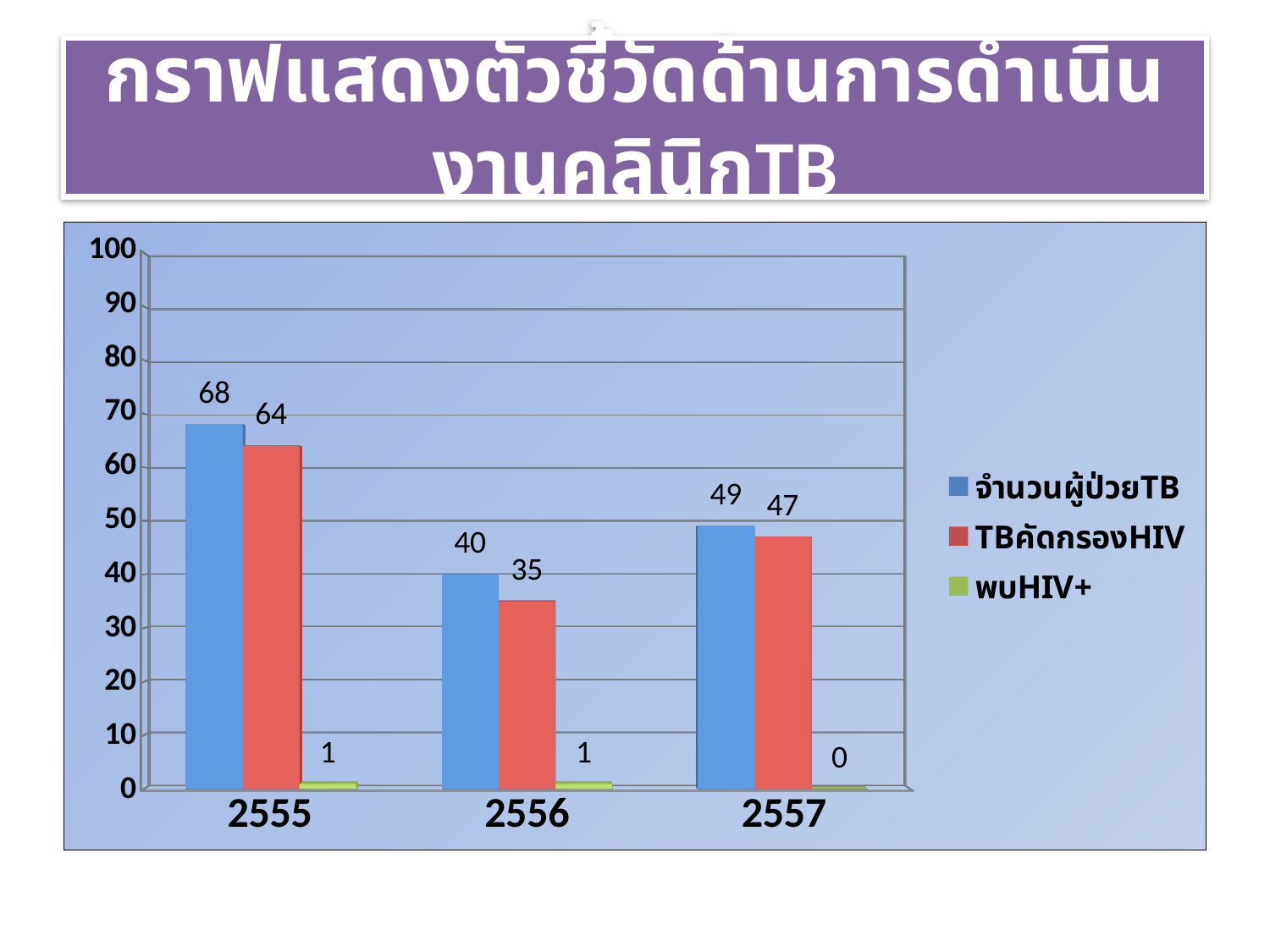
How many years are shown on the x axis? 3 What is the difference between จำนวนผู้ป่วยTB and TBคัดกรองHIV in 2556? 5 In which year is TBคัดกรองHIV lowest? 2556 What is the value of TBคัดกรองHIV in 2556? 35 What colour represents พบHIV+ in the legend? green What kind of chart is shown on the slide? bar chart Does จำนวนผู้ป่วยTB rise or fall from 2555 to 2556? fall Which is larger: จำนวนผู้ป่วยTB in 2557 or TBคัดกรองHIV in 2555? TBคัดกรองHIV in 2555 What is the value of พบHIV+ in 2557? 0 In which year is จำนวนผู้ป่วยTB highest? 2555 How many series does the legend list? 3 What is the value of จำนวนผู้ป่วยTB in 2555? 68